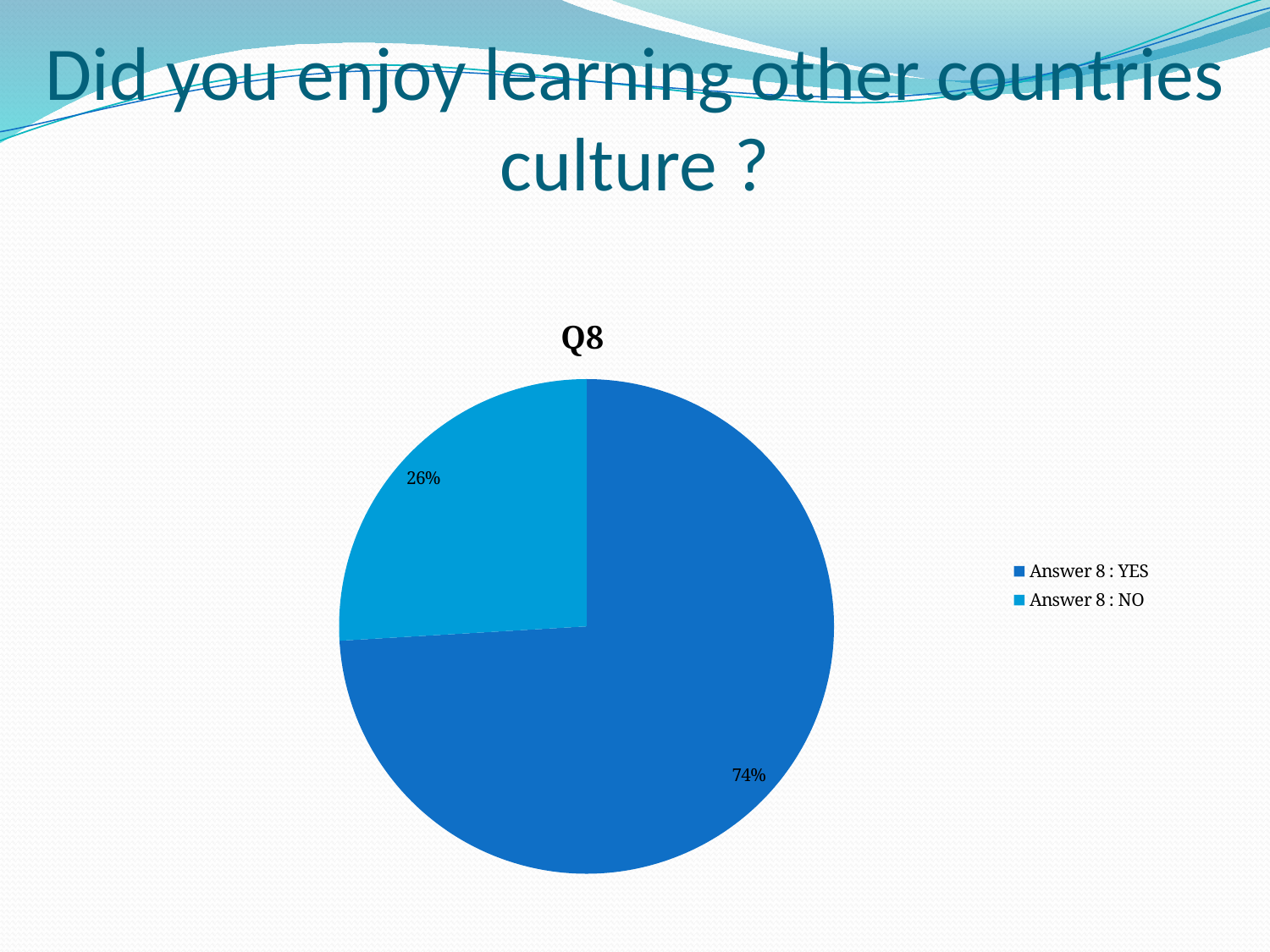
What is the chart's title? Q8 What kind of chart is shown on the slide? pie chart Which slice is the largest in the pie chart? Answer 8 : YES How many slices does the pie chart have? 2 Which is larger, the YES slice or the NO slice? Answer 8 : YES What percentage of the pie is labelled for Answer 8 : YES? 74% What percentage of the pie is labelled for Answer 8 : NO? 26% What share of the pie does the NO slice take? 26% Is the value for Answer 8 : YES greater or less than 50%? greater How many entries does the legend list? 2 Which slice is the smallest in the pie chart? Answer 8 : NO What is the difference in percentage points between the YES and NO slices? 48